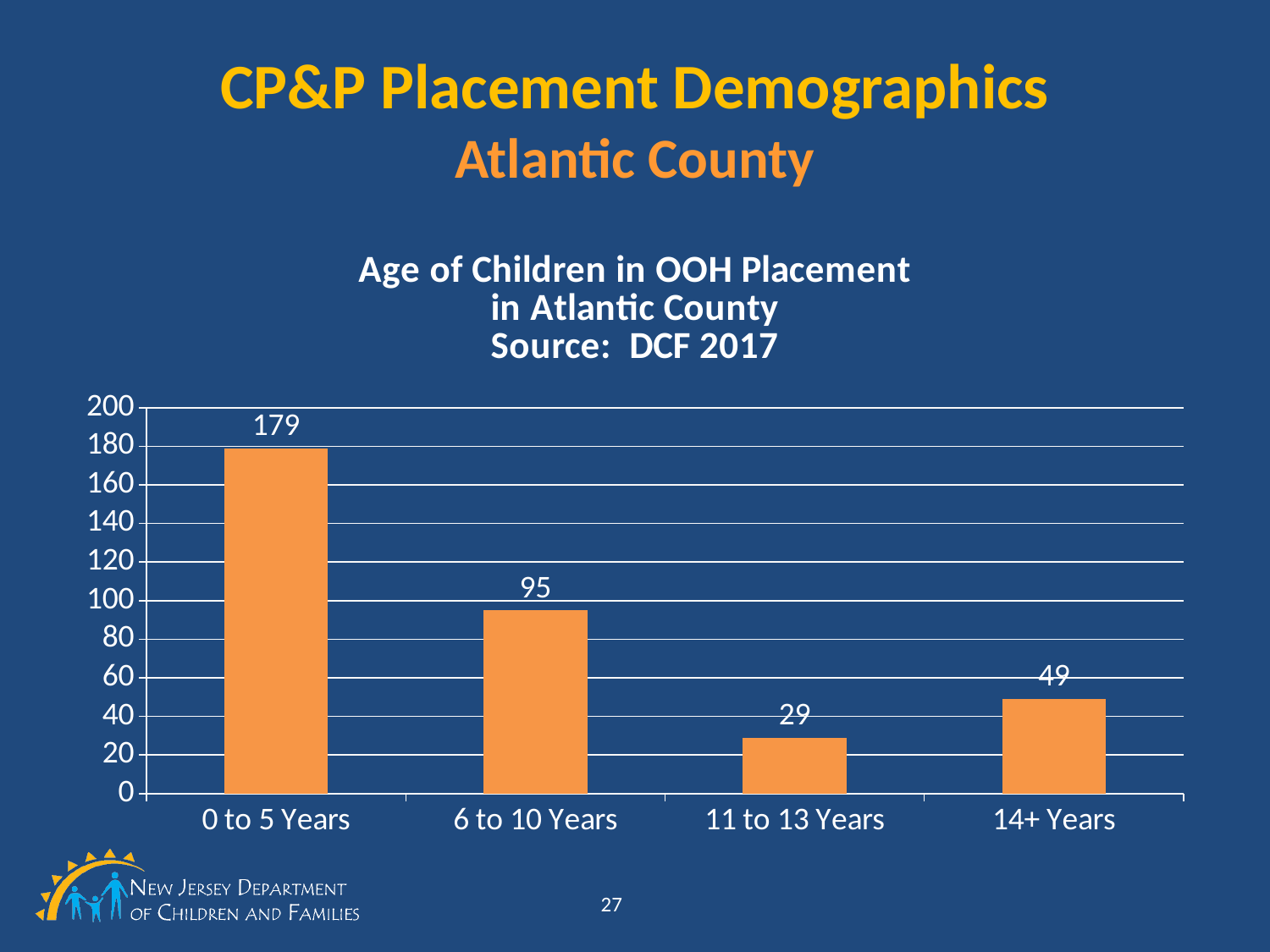
Which age group has the highest value? 0 to 5 Years How many age groups are shown on the chart? 4 What is the value for 14+ Years? 49 Which is larger, the value for 14+ Years or the value for 11 to 13 Years? 14+ Years What is the value for 11 to 13 Years? 29 Is the value for 6 to 10 Years greater or less than 100? less What is the difference between the values for 0 to 5 Years and 6 to 10 Years? 84 What kind of chart is shown on the slide? bar chart What is the value for 0 to 5 Years? 179 What is the source given in the chart title? DCF 2017 What is the value for 6 to 10 Years? 95 Which age group has the lowest value? 11 to 13 Years